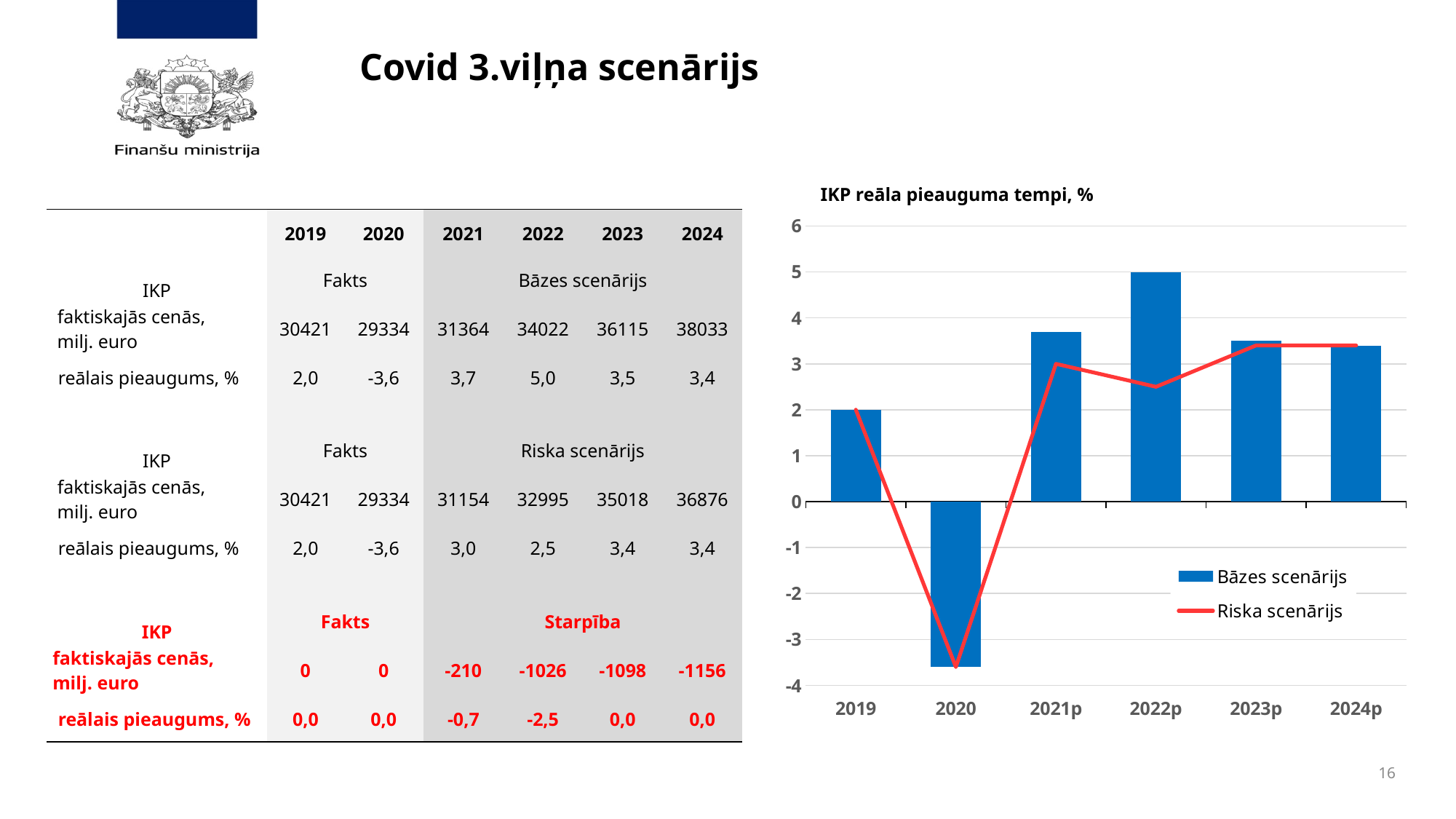
Which year has the highest Bāzes scenārijs bar in the chart? 2022p What is the title of the chart on the slide? IKP reāla pieauguma tempi, % How many series does the legend of the chart list? 2 Is the Riska scenārijs value for 2022p greater or less than 3? less What is the Bāzes scenārijs value for 2019 in the chart? 2 What is the Bāzes scenārijs value for 2022p in the chart? 5 Which year has the lowest Bāzes scenārijs bar in the chart? 2020 How many categories are shown on the x axis of the chart? 6 In 2022p, which is larger: the Bāzes scenārijs value or the Riska scenārijs value? Bāzes scenārijs What is the difference between the Bāzes scenārijs values for 2022p and 2019 in the chart? 3 What kind of chart is used for the Bāzes scenārijs series in the chart titled 'IKP reāla pieauguma tempi, %'? bar chart Is the Bāzes scenārijs value for 2021p greater or less than 3? greater